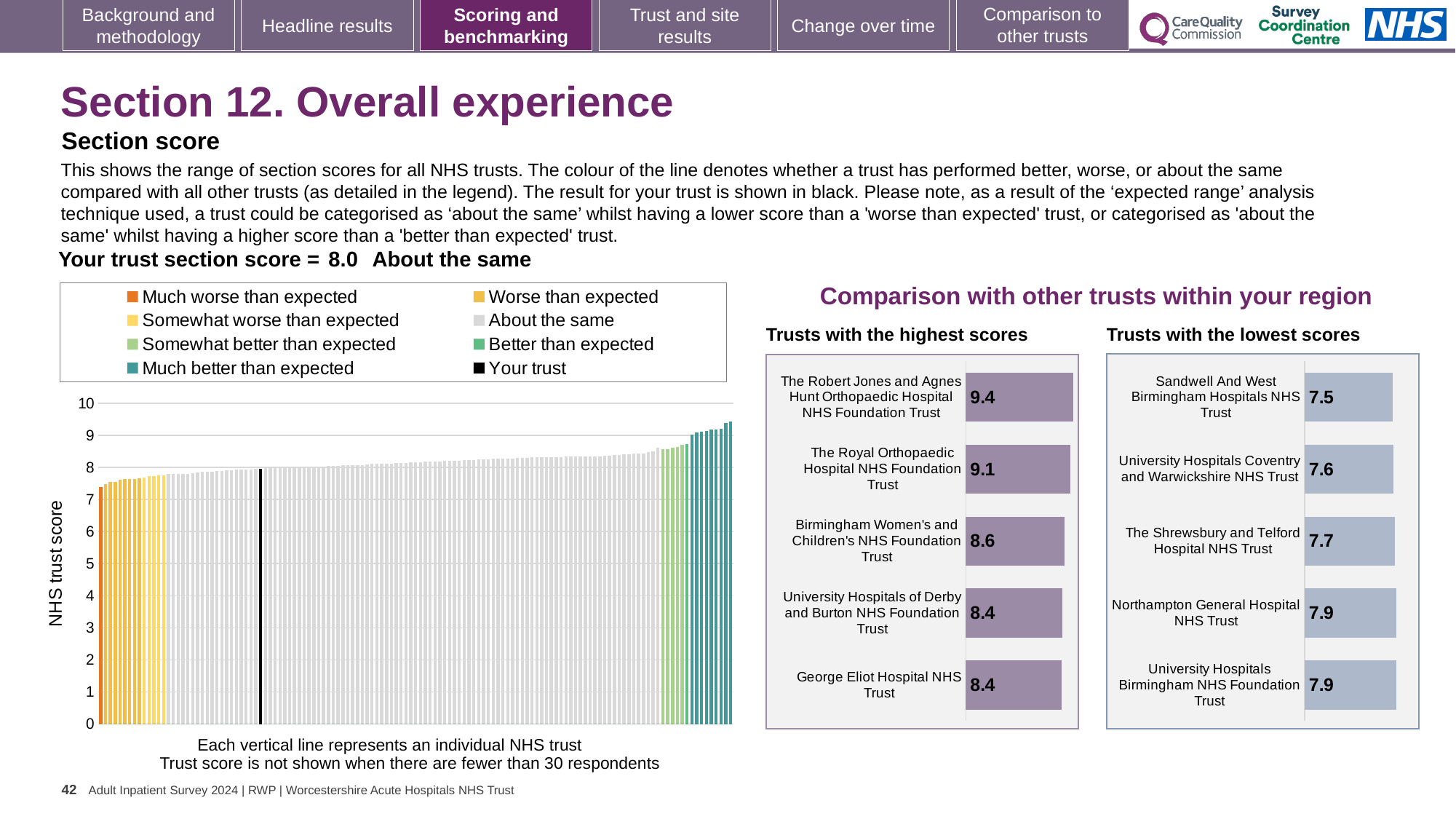
In the 'Trusts with the lowest scores' chart, what is the difference between the scores of Northampton General Hospital NHS Trust and Sandwell And West Birmingham Hospitals NHS Trust? 0.4 In the 'Trusts with the lowest scores' chart, which trust has the lowest score? Sandwell And West Birmingham Hospitals NHS Trust How many trusts are listed in the 'Trusts with the lowest scores' chart? 5 How many entries does the legend of the large chart on the left list? 8 In the 'Trusts with the highest scores' chart, which has the higher score: The Royal Orthopaedic Hospital NHS Foundation Trust or Birmingham Women's and Children's NHS Foundation Trust? The Royal Orthopaedic Hospital NHS Foundation Trust In the 'Trusts with the highest scores' chart, what is the score for Birmingham Women's and Children's NHS Foundation Trust? 8.6 In the 'Trusts with the highest scores' chart, which trust has the highest score? The Robert Jones and Agnes Hunt Orthopaedic Hospital NHS Foundation Trust In the 'Trusts with the lowest scores' chart, what is the score for University Hospitals Coventry and Warwickshire NHS Trust? 7.6 What kind of chart is the large chart on the left showing NHS trust scores? Bar chart In the large chart on the left, do the trust scores rise or fall from left to right along the x axis? Rise In the 'Trusts with the highest scores' chart, what is the score for The Robert Jones and Agnes Hunt Orthopaedic Hospital NHS Foundation Trust? 9.4 In the 'Trusts with the highest scores' chart, what is the difference between the scores of The Robert Jones and Agnes Hunt Orthopaedic Hospital NHS Foundation Trust and Birmingham Women's and Children's NHS Foundation Trust? 0.8